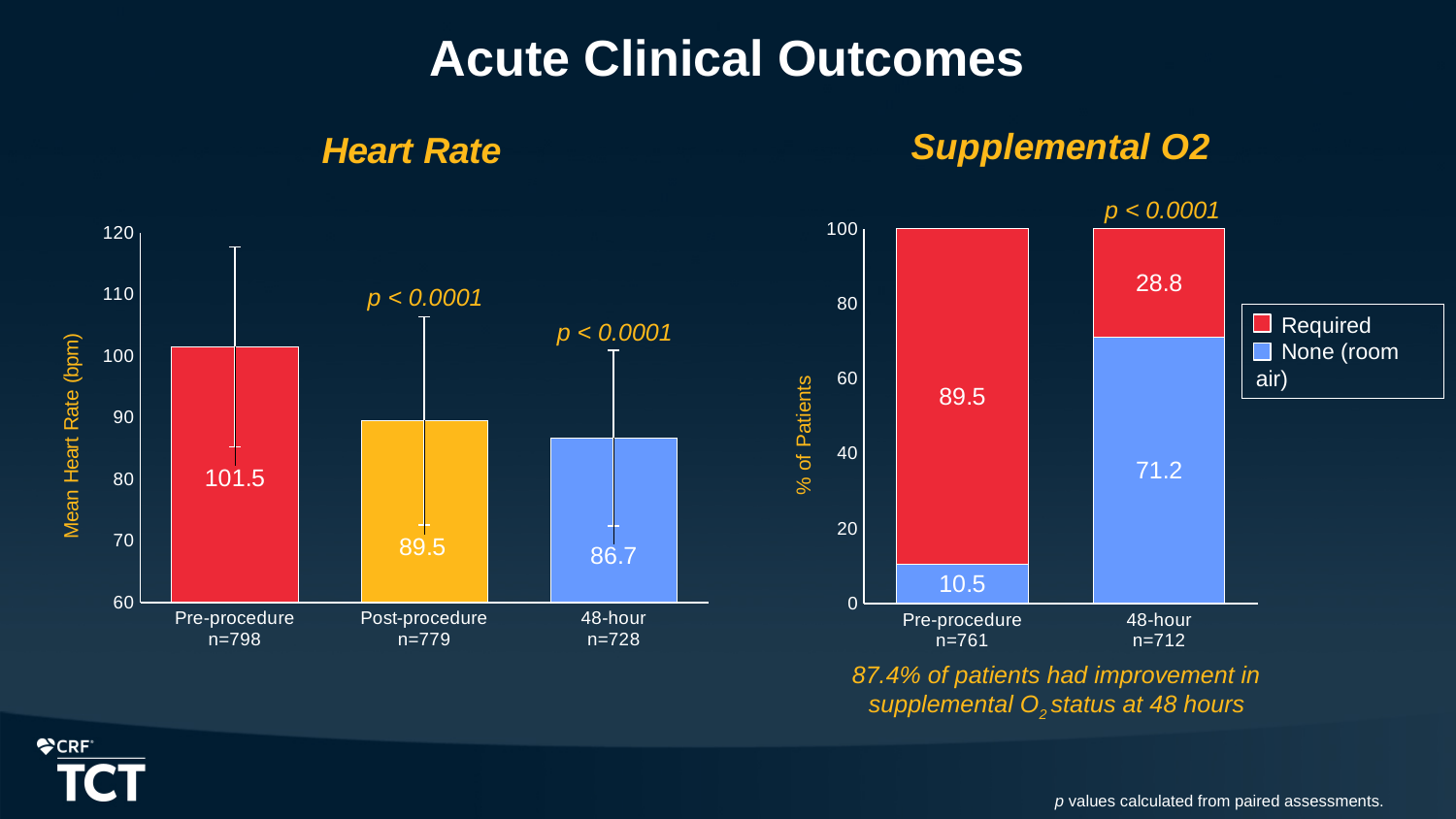
In the Supplemental O2 chart, what is the difference between the Required percentages at Pre-procedure and 48-hour? 60.7 What kind of chart is the Supplemental O2 chart? stacked bar chart In the Heart Rate chart, what is the mean heart rate for Pre-procedure? 101.5 In the Supplemental O2 chart, what percentage of patients were on room air (None) at 48-hour? 71.2 In the Supplemental O2 chart, what percentage of patients required supplemental O2 at Pre-procedure? 89.5 In the Supplemental O2 chart, how many series does the legend list? 2 In the Heart Rate chart, what is the mean heart rate at 48-hour? 86.7 In the Supplemental O2 chart, which is larger at 48-hour: Required or None (room air)? None (room air) In the Heart Rate chart, what is the difference between the Pre-procedure and Post-procedure mean heart rates? 12.0 In the Heart Rate chart, how many categories are shown on the x axis? 3 In the Heart Rate chart, do the values rise or fall from Pre-procedure to 48-hour? fall In the Heart Rate chart, which category has the lowest mean heart rate? 48-hour